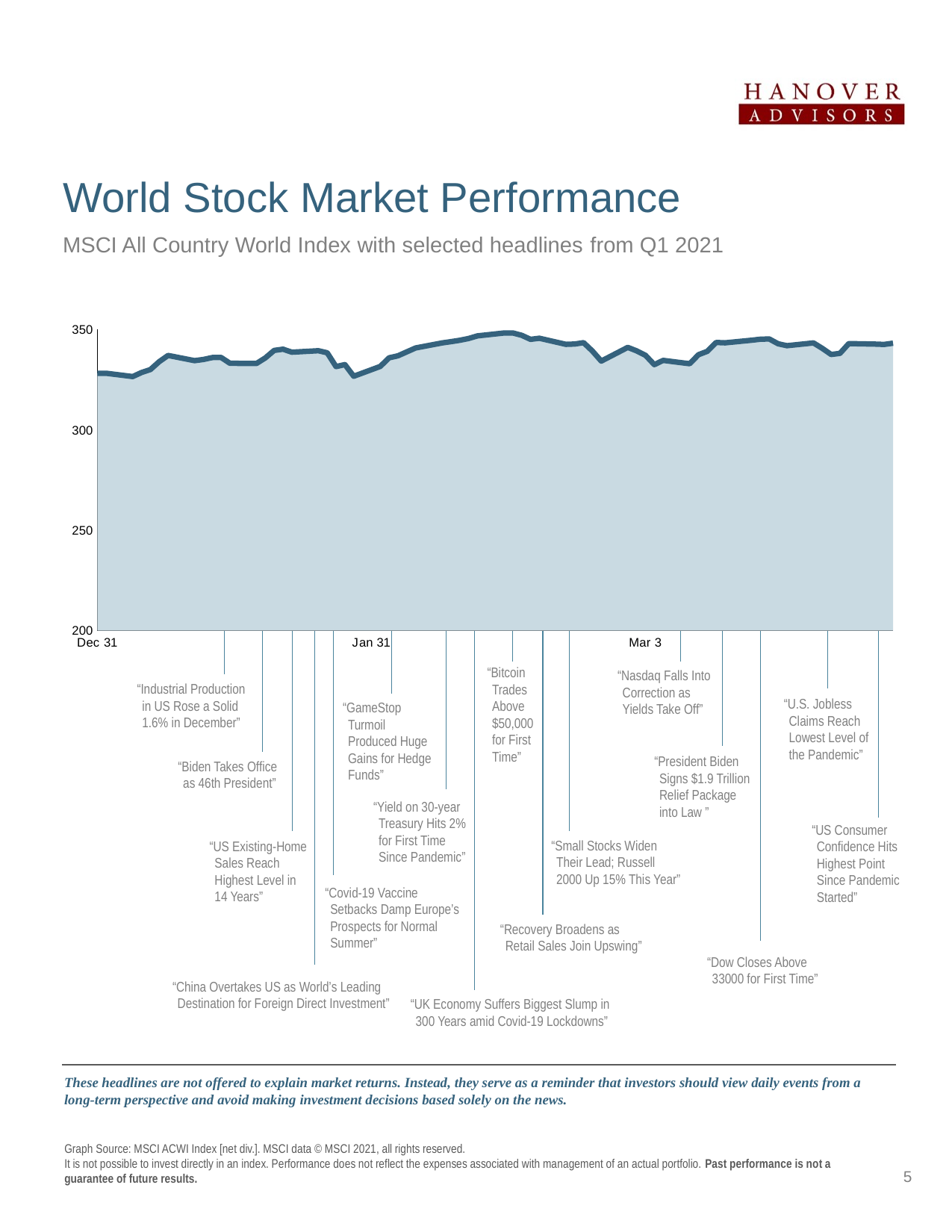
What is the title of the slide's chart? World Stock Market Performance Is the lowest point of the index line greater or less than 300? greater Is the index value at Dec 31 greater or less than 300? greater Is the index value at Dec 31 greater or less than 350? less How many date labels are shown on the horizontal axis? 3 What kind of chart is shown on the slide? Area chart Which date label appears first on the horizontal axis? Dec 31 Does the index generally rise or fall from Dec 31 to the end of the quarter? rise Which index does the chart plot? MSCI All Country World Index